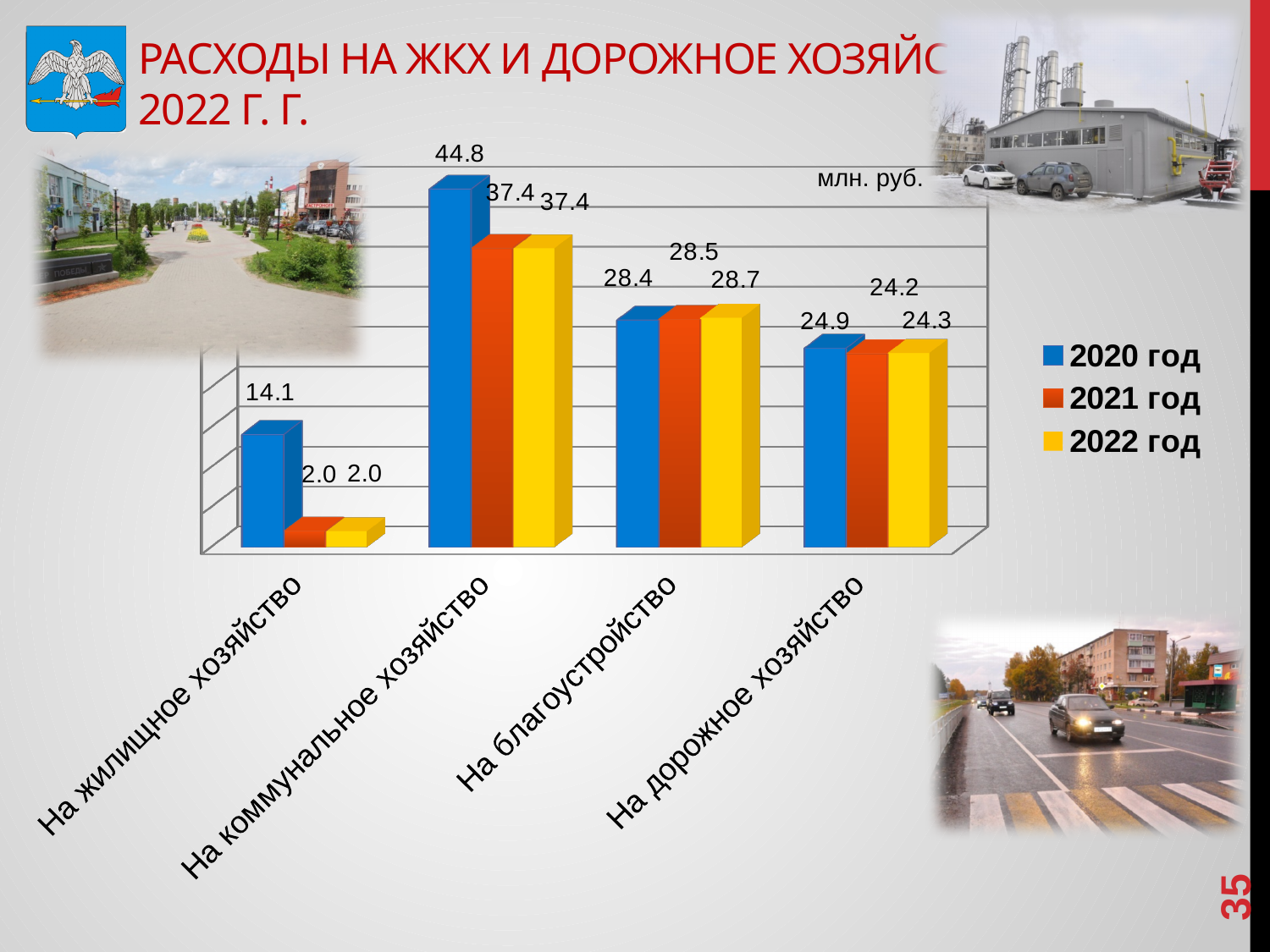
What is the difference between the 2020 год and 2021 год values for На жилищное хозяйство? 12.1 What is the value for 2022 год in the category На благоустройство? 28.7 Which category has the lowest value for 2022 год? На жилищное хозяйство What type of chart is shown on the slide? bar chart What is the value for 2020 год in the category На коммунальное хозяйство? 44.8 What unit is indicated for the values in the chart? млн. руб. Which is larger for На дорожное хозяйство: the value for 2020 год or the value for 2022 год? 2020 год How many categories are shown on the x axis of the chart? 4 What is the value for 2021 год in the category На дорожное хозяйство? 24.2 Which category has the highest value for 2020 год? На коммунальное хозяйство What is the value for 2021 год in the category На жилищное хозяйство? 2.0 How many series does the legend list? 3